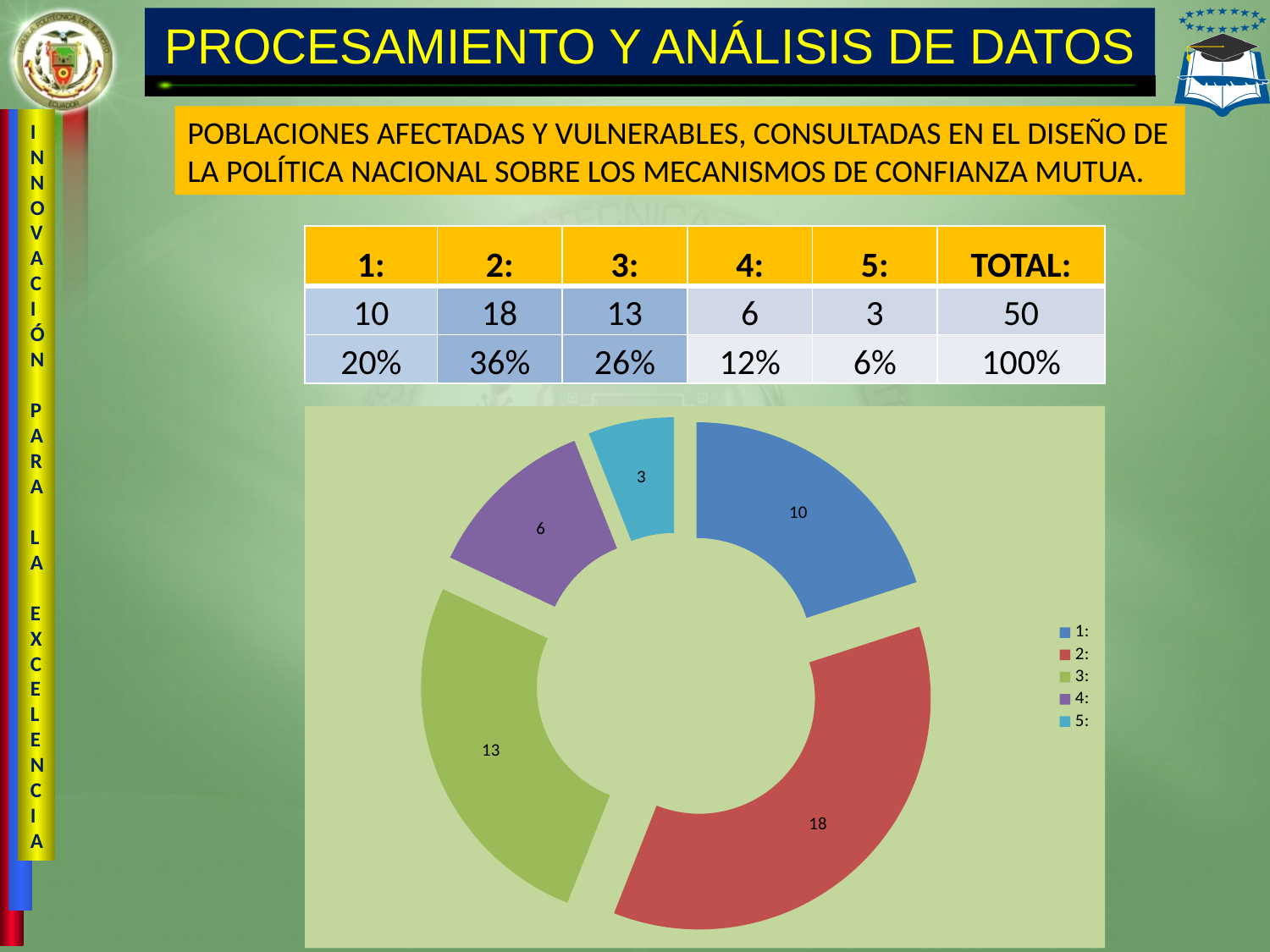
Which category has the smallest value in the doughnut chart? 5: What is the value for category 2: in the doughnut chart? 18 What share of the total does category 1: represent in the doughnut chart? 20% Which category has the largest value in the doughnut chart? 2: What type of chart is shown on the slide? Doughnut chart How many categories are shown in the doughnut chart? 5 What is the value for category 5: in the doughnut chart? 3 How many entries does the legend of the doughnut chart list? 5 Which is larger in the doughnut chart, the value for category 3: or category 4:? 3: What is the value for category 3: in the doughnut chart? 13 What is the difference between the values for category 2: and category 1: in the doughnut chart? 8 What colour is the segment for category 2: in the doughnut chart? Red